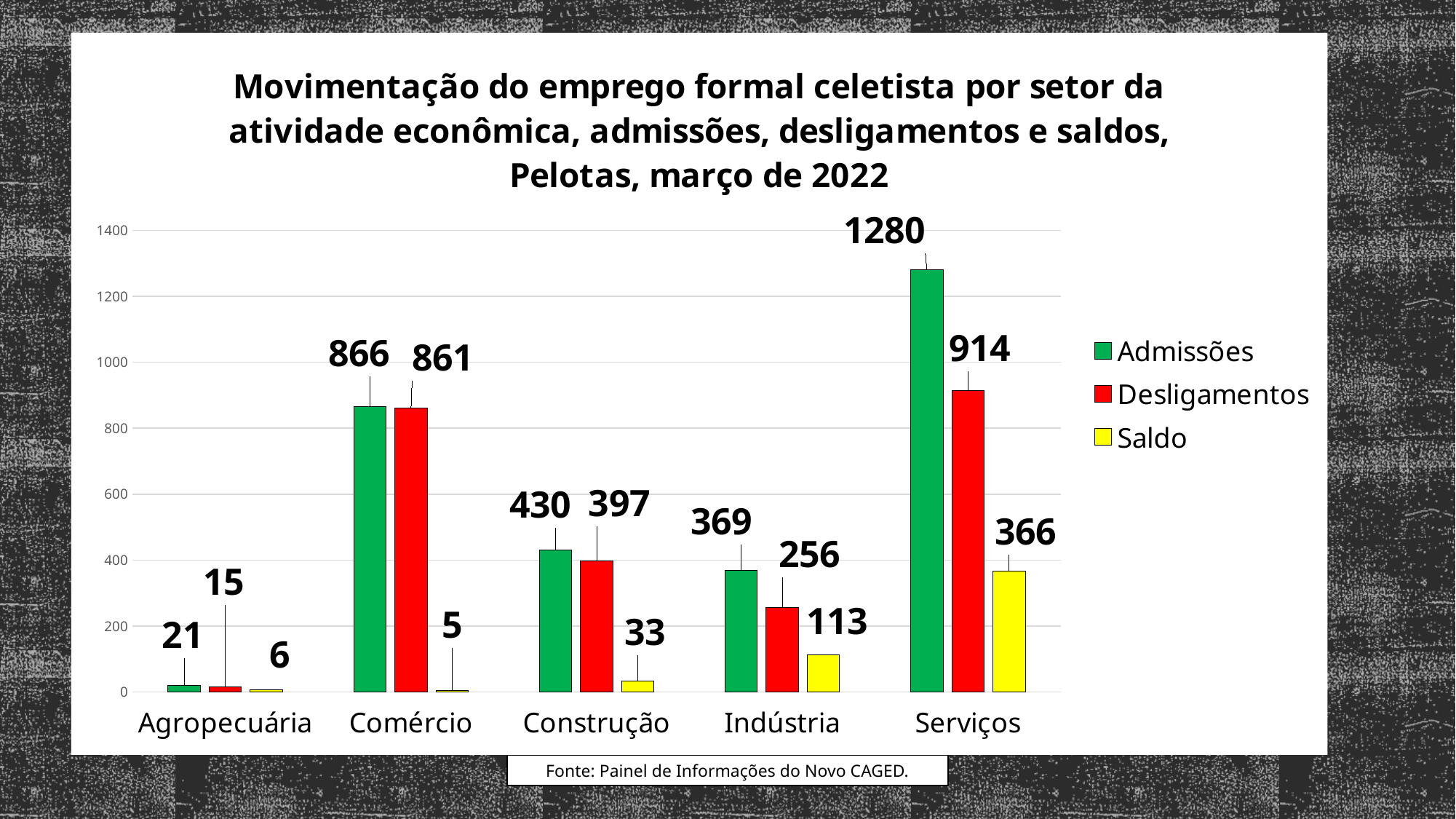
How many series does the legend list? 3 Which colour represents the Saldo series in the legend? Yellow What kind of chart is shown on the slide? Bar chart Which is larger for Indústria: Admissões or Desligamentos? Admissões What is the difference between Admissões and Desligamentos for Construção? 33 What is the Desligamentos value for Comércio? 861 How many sectors are shown on the x axis? 5 Is the Desligamentos value for Serviços greater or less than 800? greater What is the Admissões value for Serviços? 1280 What is the Saldo value for Indústria? 113 Which sector has the highest Admissões value? Serviços Which sector has the lowest Saldo value? Comércio